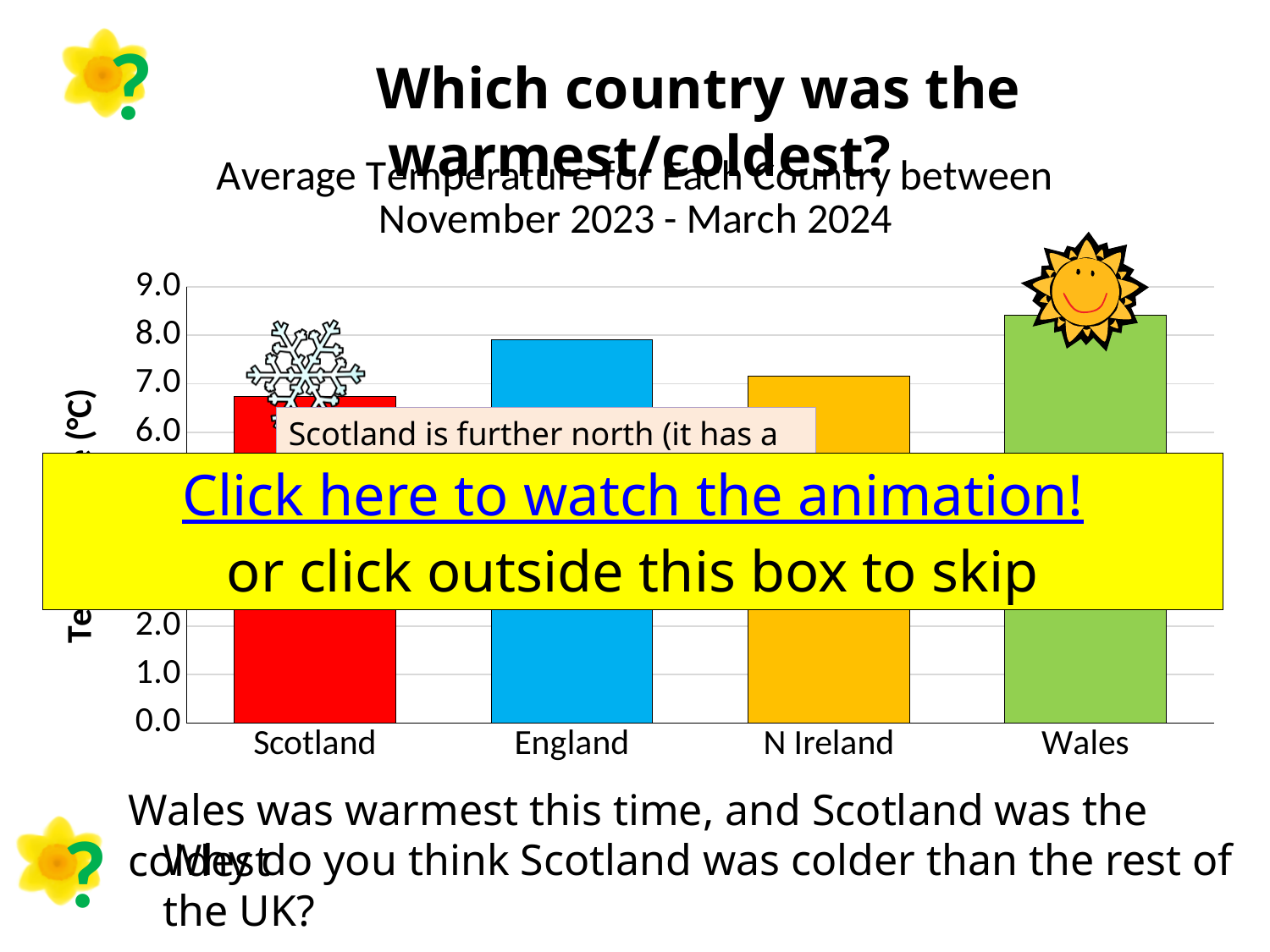
Is the value for Scotland greater or less than 7.0? less How many countries are shown on the chart? 4 What colour is the bar for Scotland? red Which has the higher average temperature, England or N Ireland? England Which country has the highest average temperature on the chart? Wales What kind of chart is shown on the slide? bar chart Is the value for England greater or less than 7.0? greater Is the value for Wales greater or less than 8.0? greater Which country has the lowest average temperature on the chart? Scotland Which has the higher average temperature, Scotland or Wales? Wales What is the title of the chart? Average Temperature for Each Country between November 2023 - March 2024